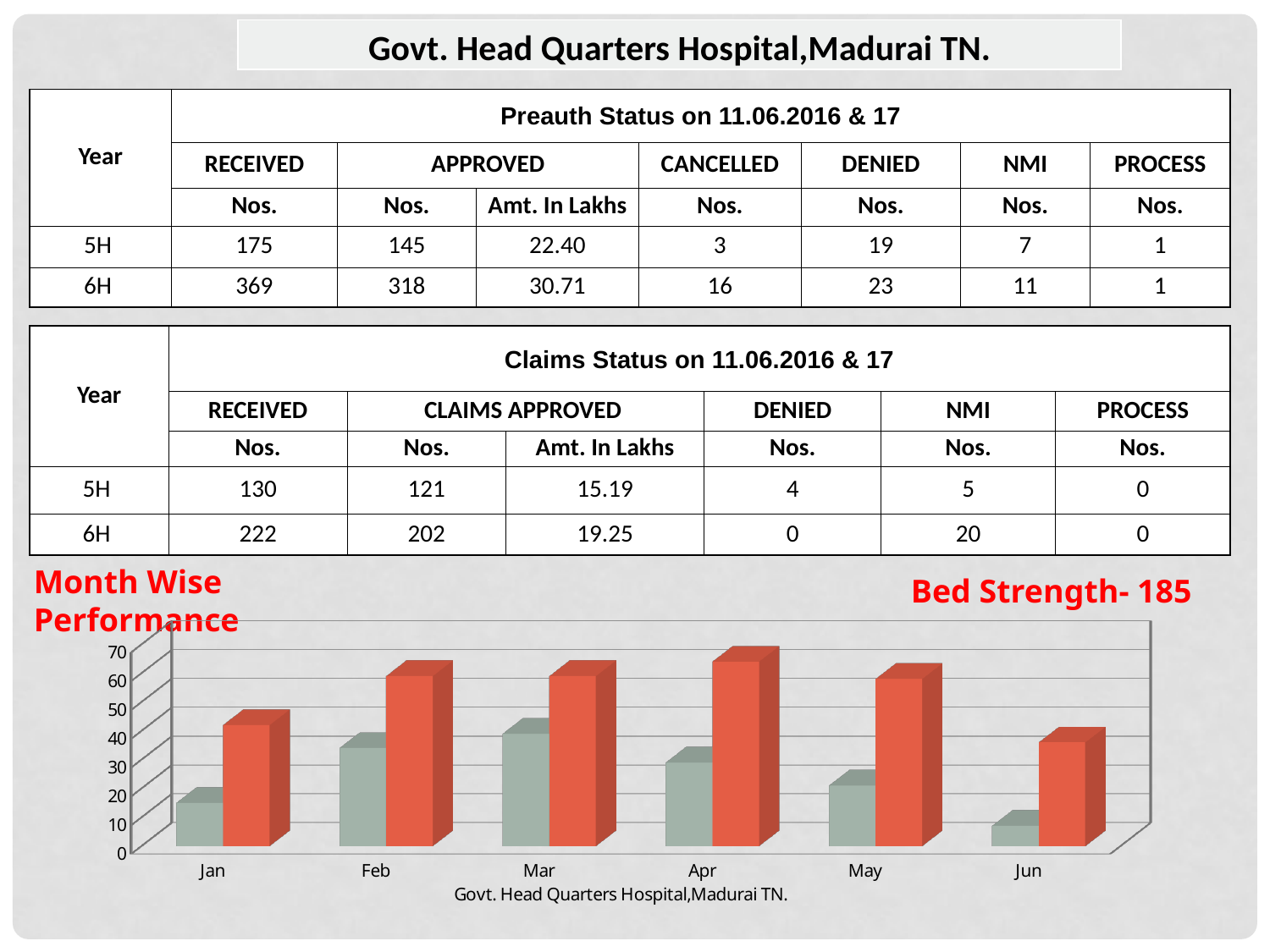
In the bar chart, which month has the shortest red bar? Jun In the bar chart, is the grey bar for Feb greater or less than 20? greater In the bar chart, which is taller for Jan: the red bar or the grey bar? the red bar How many months are shown on the x axis of the bar chart? 6 In the bar chart, is the grey bar for Jun greater or less than 20? less How many data series are plotted in the bar chart? 2 In the bar chart, which month has the shortest grey bar? Jun What kind of chart is shown at the bottom of the slide? bar chart In the bar chart, which month has the tallest red bar? Apr In the bar chart, do the grey bars rise or fall from Mar to Jun? fall In the bar chart, is the red bar for Apr greater or less than 50? greater In the bar chart, which month has the tallest grey bar? Mar